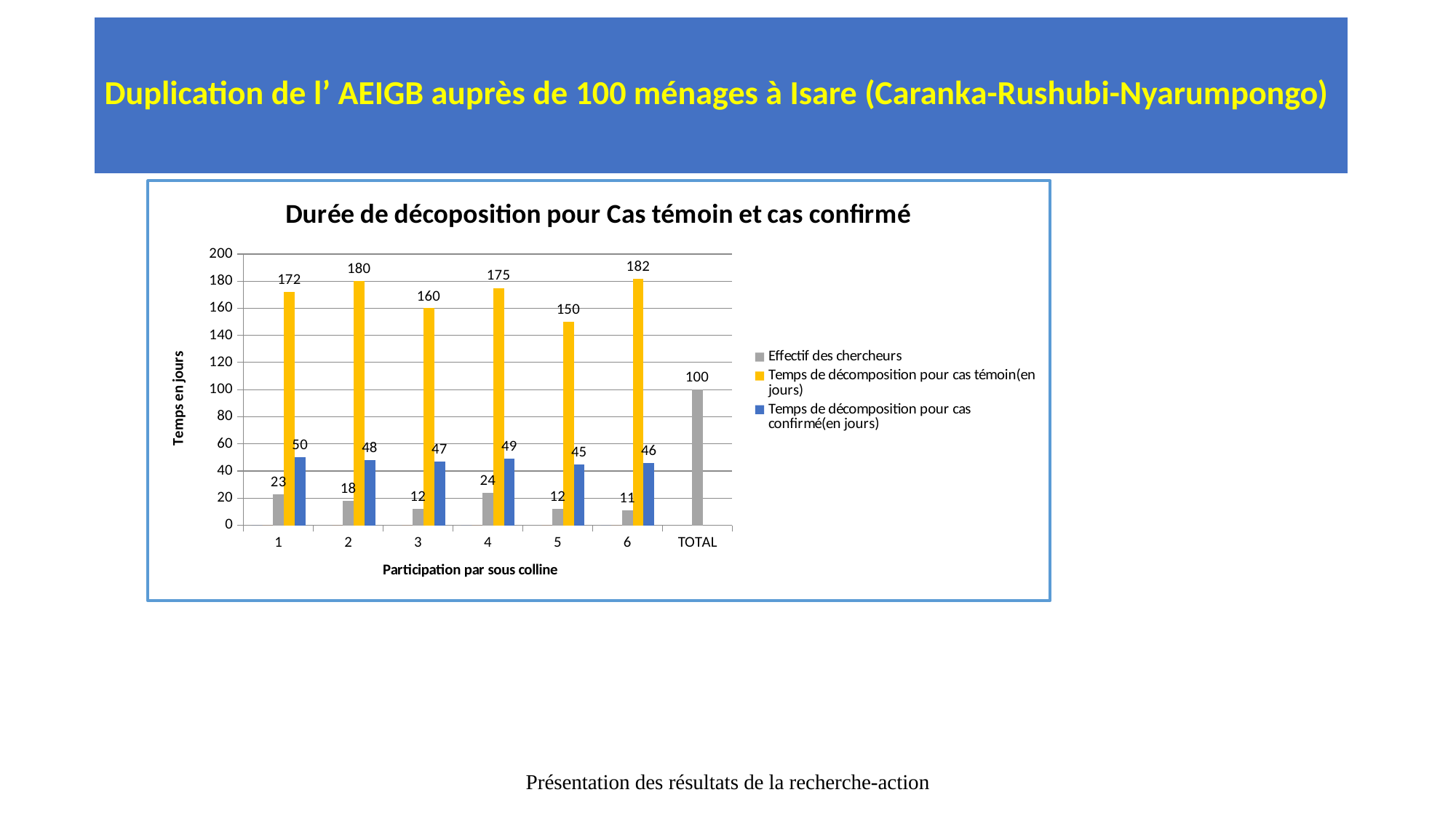
What is the value of 'Temps de décomposition pour cas confirmé(en jours)' for category 5? 45 What is the value of 'Temps de décomposition pour cas témoin(en jours)' for category 2? 180 Which is larger: 'Temps de décomposition pour cas confirmé(en jours)' for category 1 or for category 6? Category 1 How many series does the legend list? 3 What is the value of 'Effectif des chercheurs' for category 4? 24 What is the value of 'Effectif des chercheurs' for the TOTAL category? 100 Which category has the lowest value for 'Temps de décomposition pour cas témoin(en jours)'? 5 How many categories are shown on the x axis? 7 Which category has the highest value for 'Temps de décomposition pour cas témoin(en jours)'? 6 What is the title of the chart? Durée de décoposition pour Cas témoin et cas confirmé What is the difference between the 'Temps de décomposition pour cas témoin(en jours)' values for categories 6 and 5? 32 What kind of chart is shown on the slide? Bar chart